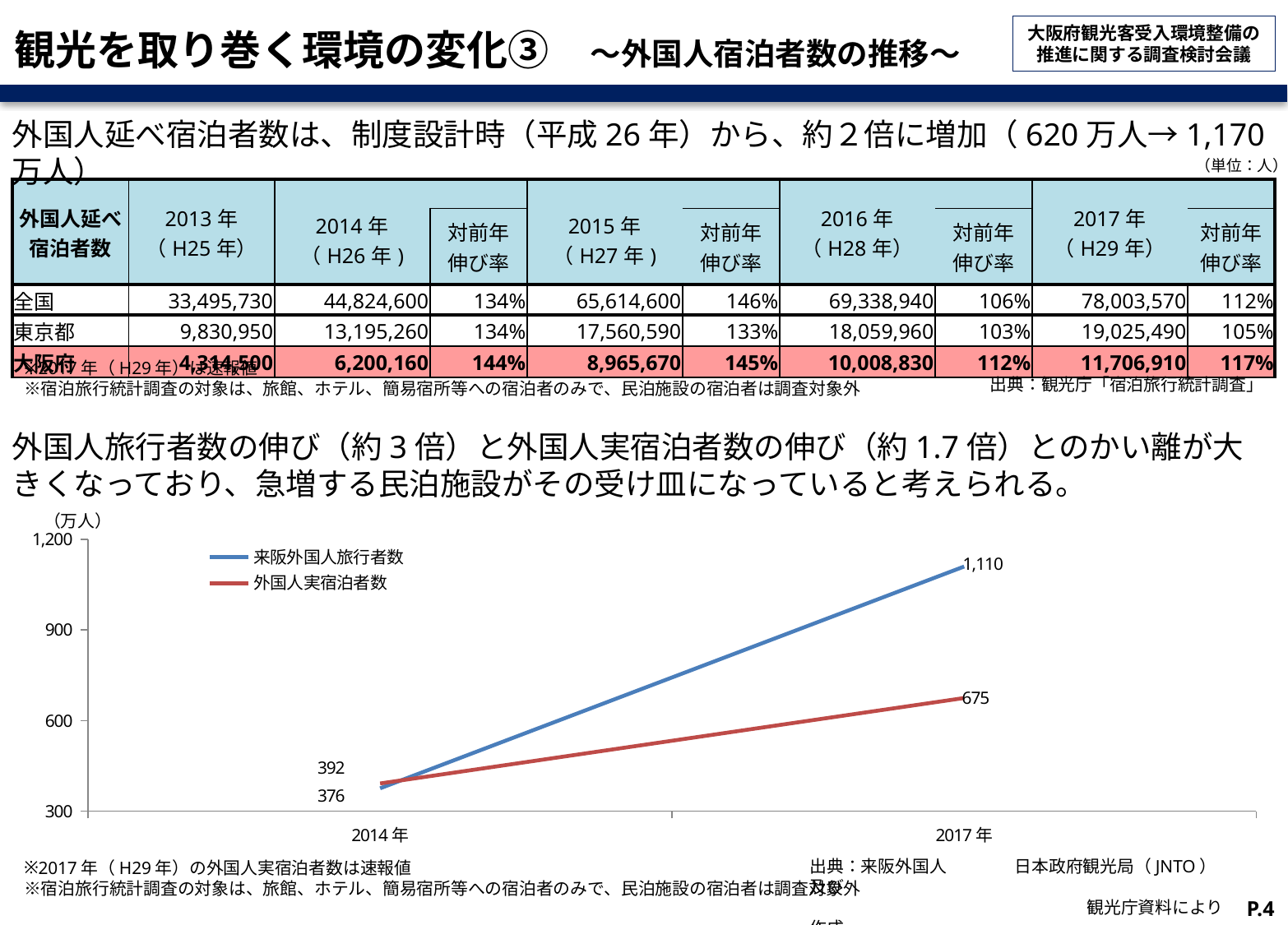
What is the value of 来阪外国人旅行者数 in 2014年? 376 Does 外国人実宿泊者数 rise or fall from 2014年 to 2017年? rise In 2017年, which series has the larger value, 来阪外国人旅行者数 or 外国人実宿泊者数? 来阪外国人旅行者数 What is the value of 来阪外国人旅行者数 in 2017年? 1,110 How many years are shown on the x axis of the chart? 2 By how much did 来阪外国人旅行者数 increase from 2014年 to 2017年? 734 What is the value of 外国人実宿泊者数 in 2014年? 392 How many series does the chart legend list? 2 What is the value of 外国人実宿泊者数 in 2017年? 675 What is the difference between 来阪外国人旅行者数 and 外国人実宿泊者数 in 2017年? 435 What colour is the line for 来阪外国人旅行者数? blue What type of chart is shown on the slide? line chart